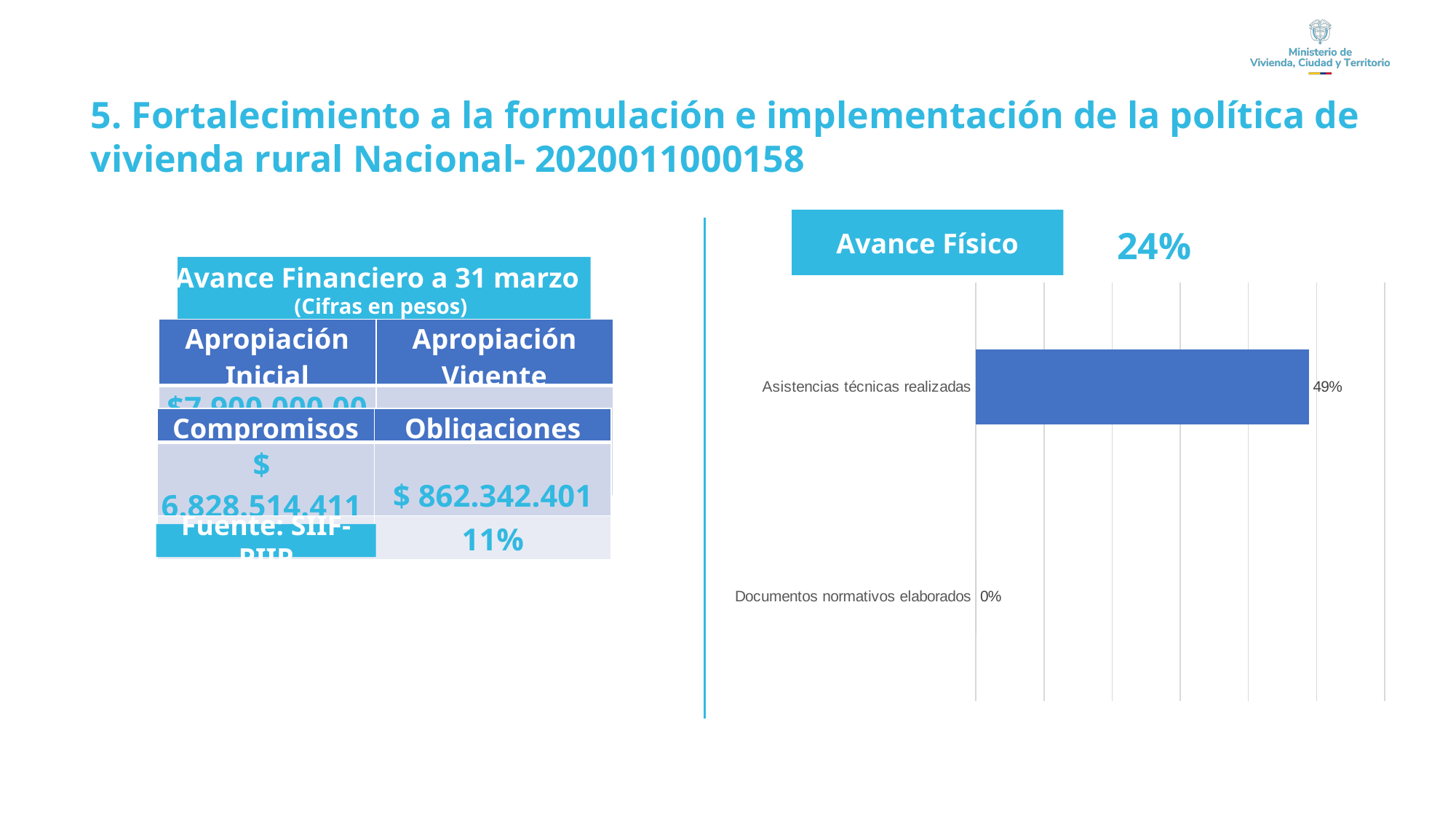
What overall percentage is shown next to the Avance Físico chart title? 24% How many categories are shown in the Avance Físico chart? 2 What is the value for Asistencias técnicas realizadas in the Avance Físico chart? 49% What is the difference between the values for Asistencias técnicas realizadas and Documentos normativos elaborados in the Avance Físico chart? 49% What is the title of the chart on the right side of the slide? Avance Físico Which category has the highest value in the Avance Físico chart? Asistencias técnicas realizadas In the Avance Físico chart, which is larger: Asistencias técnicas realizadas or Documentos normativos elaborados? Asistencias técnicas realizadas What is the value for Documentos normativos elaborados in the Avance Físico chart? 0% Which category has the lowest value in the Avance Físico chart? Documentos normativos elaborados What kind of chart is the Avance Físico chart? Bar chart